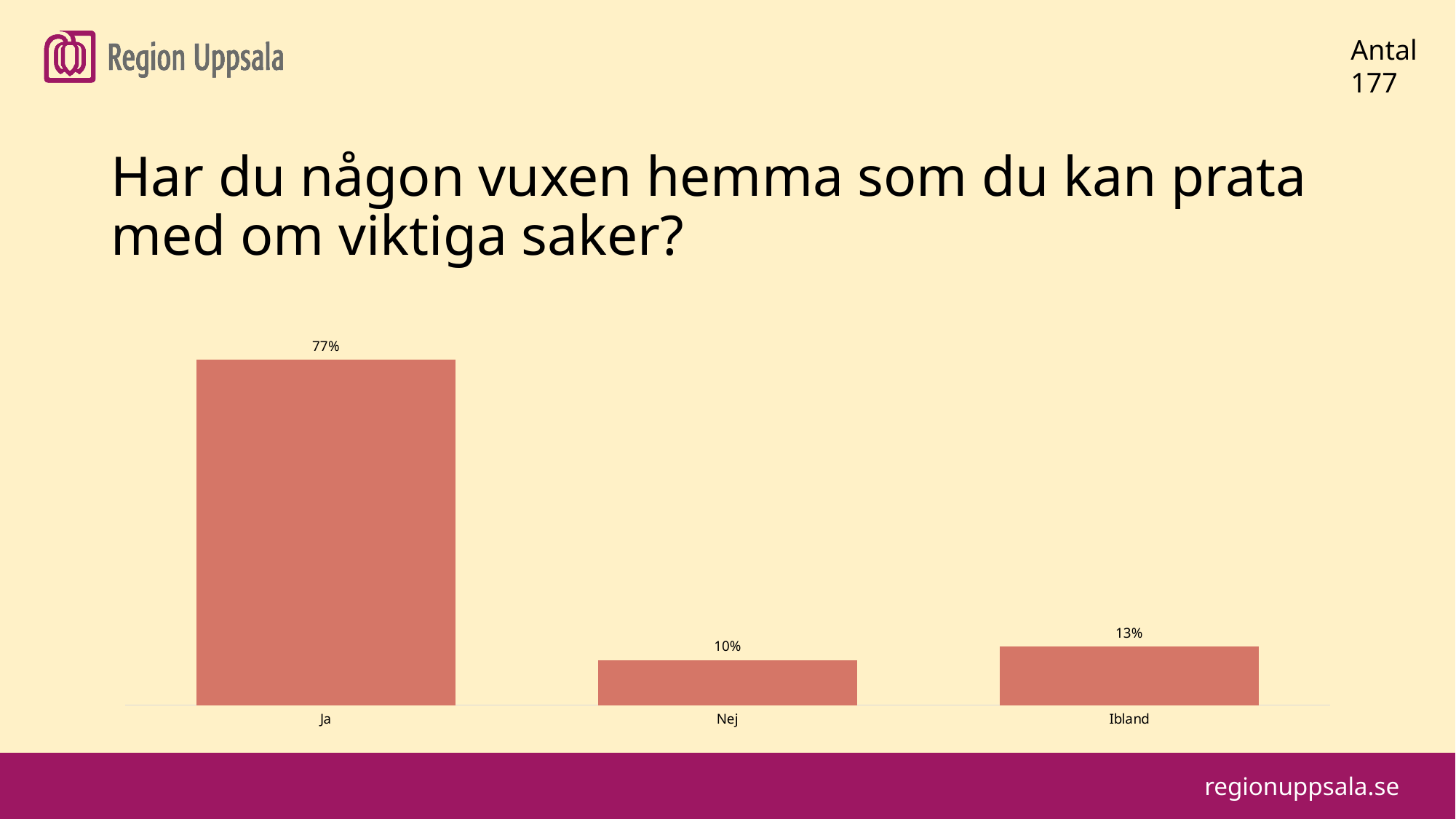
What is the total of the three values shown in the chart? 100% What kind of chart is shown on the slide? Bar chart What is the value for Ibland? 13% What is the difference between the values for Ja and Ibland? 64% How many categories are shown in the chart? 3 What is the difference between the values for Ibland and Nej? 3% Which category has the lowest value? Nej What is the value for Nej? 10% What number is shown next to 'Antal' in the top right corner of the slide? 177 Which category has the highest value? Ja What is the value for Ja? 77% Which is larger, the value for Nej or the value for Ibland? Ibland